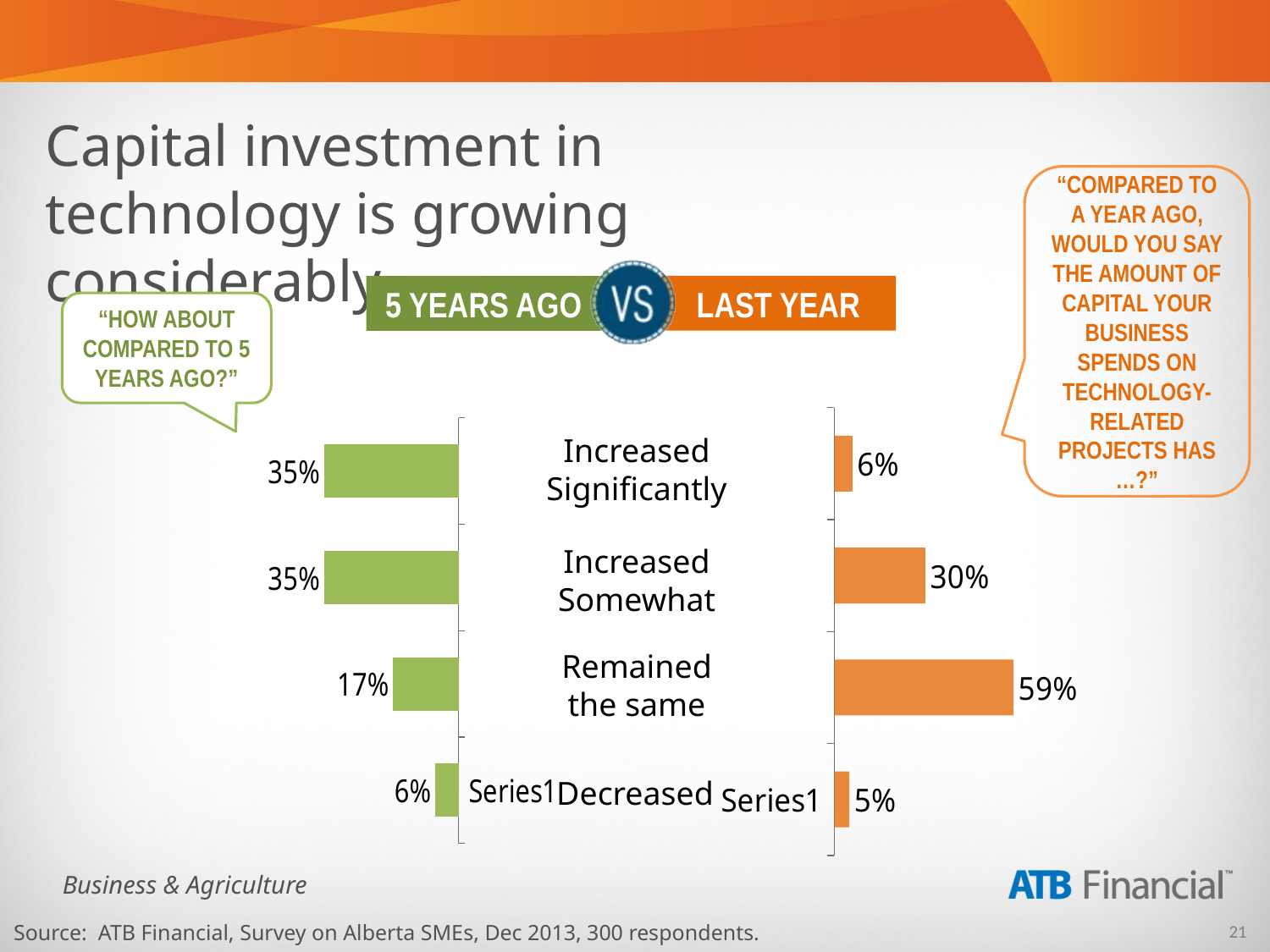
In the 'last year' (orange, right) chart, what is the value for 'Increased Somewhat'? 30% How many categories does each chart show? 4 In the '5 years ago' (green, left) chart, which category has the lowest value? Decreased In the 'last year' (orange, right) chart, which category has the lowest value? Decreased Which is larger: 'Increased Significantly' in the '5 years ago' chart or 'Increased Significantly' in the 'last year' chart? 5 years ago What type of chart is used on this slide? Bar chart What legend label appears under each chart? Series1 In the 'last year' (orange, right) chart, which category has the highest value? Remained the same In the '5 years ago' (green, left) chart, what is the value for 'Decreased'? 6% In the 'last year' (orange, right) chart, what is the value for 'Increased Significantly'? 6% What is the difference between the 'Remained the same' values in the 'last year' chart (59%) and the '5 years ago' chart (17%)? 42% In the '5 years ago' (green, left) chart, what is the value for 'Remained the same'? 17%